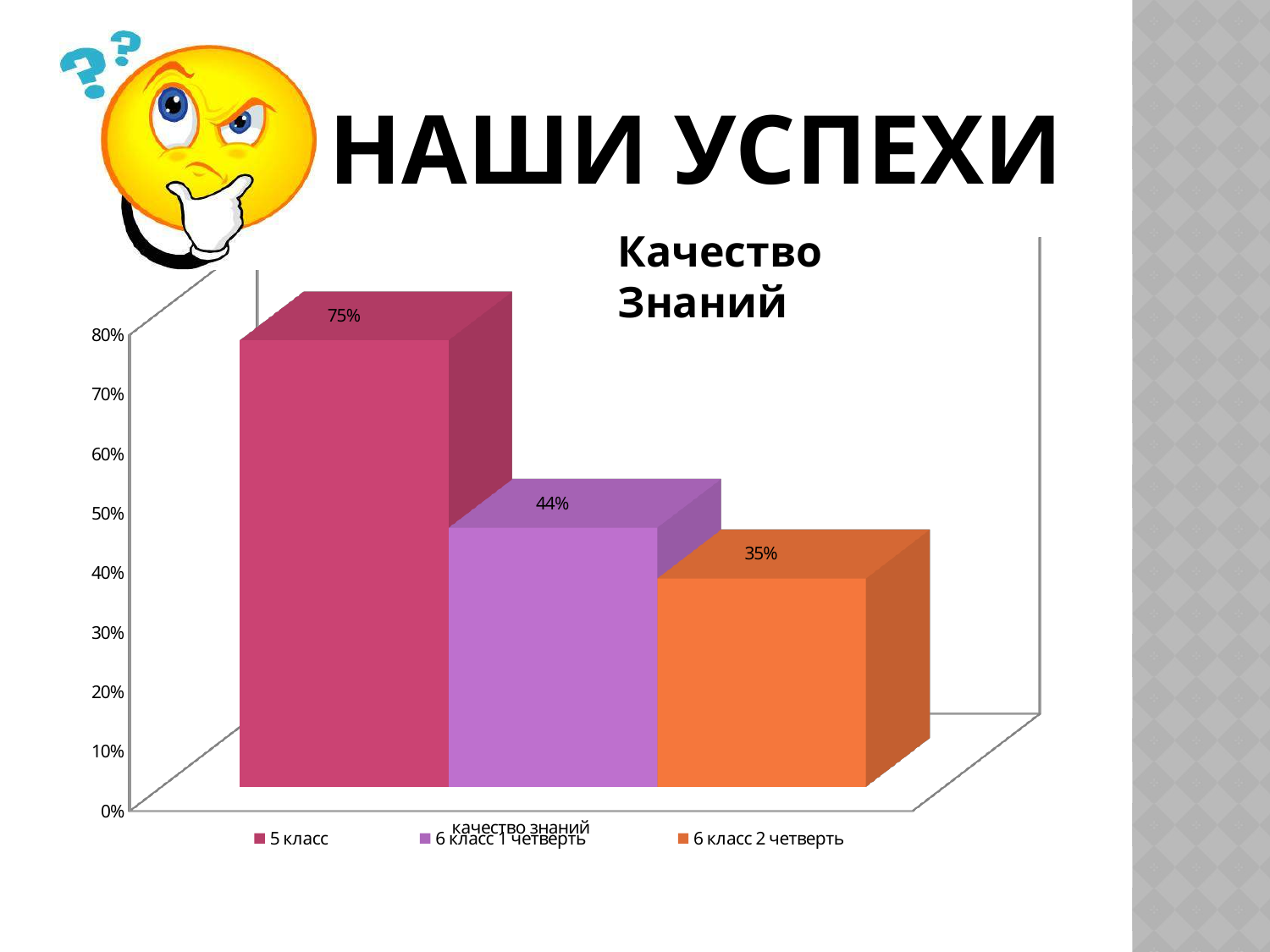
Which series has the lowest value? 6 класс 2 четверть What is the value for 6 класс 2 четверть? 35% What kind of chart is shown on the slide? bar chart Which series has the highest value? 5 класс What is the title of the chart? Качество Знаний Which is larger, the value for 6 класс 1 четверть or 6 класс 2 четверть? 6 класс 1 четверть How many series does the legend list? 3 What is the difference between the values for 5 класс and 6 класс 1 четверть? 31% Do the values rise or fall from 5 класс to 6 класс 2 четверть? fall What is the value for 5 класс? 75% What is the difference between the values for 6 класс 1 четверть and 6 класс 2 четверть? 9% What is the value for 6 класс 1 четверть? 44%